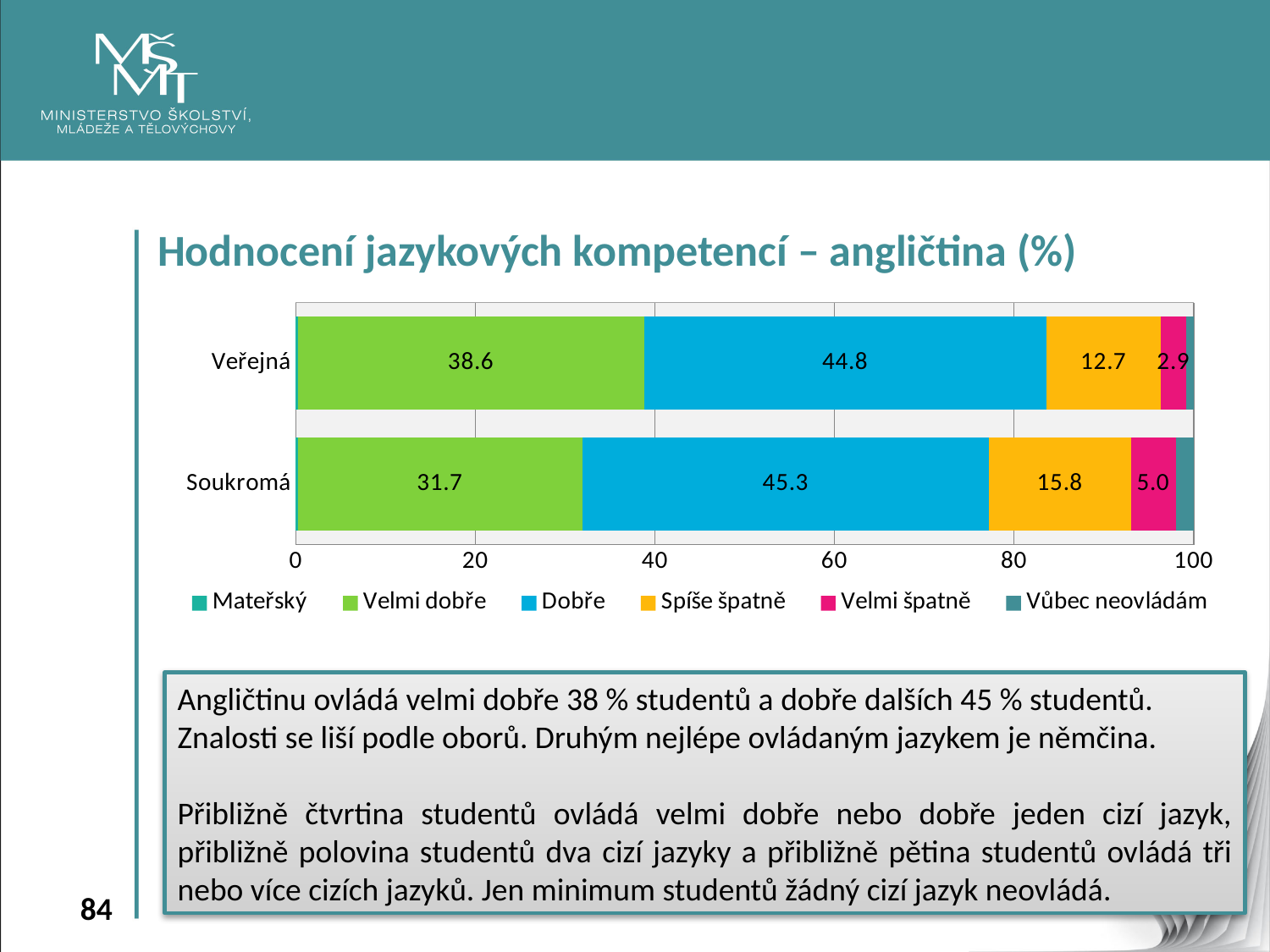
What is the value for "Velmi špatně" in the Soukromá bar? 5.0 What is the value for "Velmi dobře" in the Veřejná bar? 38.6 What is the value for "Spíše špatně" in the Veřejná bar? 12.7 Which category has the larger "Velmi dobře" value, Veřejná or Soukromá? Veřejná Which category has the larger "Spíše špatně" value, Veřejná or Soukromá? Soukromá What kind of chart is shown on the slide? Stacked bar chart How many categories are shown on the vertical axis of the chart? 2 What is the title of the chart? Hodnocení jazykových kompetencí – angličtina (%) What is the difference between the "Velmi špatně" values for Soukromá and Veřejná? 2.1 How many series does the legend list? 6 What is the difference between the "Velmi dobře" values for Veřejná and Soukromá? 6.9 What is the value for "Dobře" in the Soukromá bar? 45.3